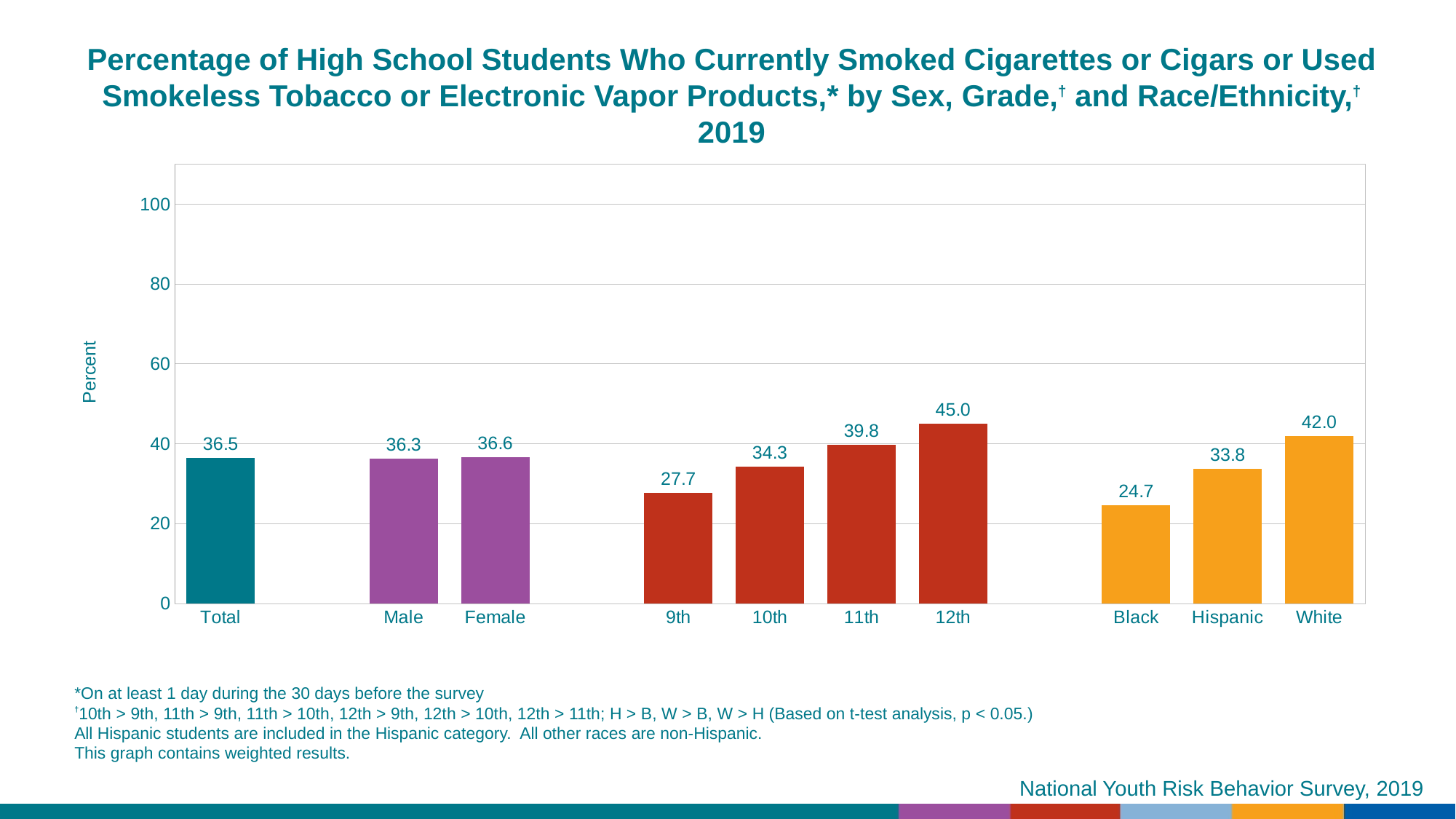
Which category has the highest value? 12th What is the difference between the values for 12th and 9th grade students? 17.3 What is the value for Black students? 24.7 Which is larger, the value for 11th grade or the value for Hispanic students? 11th Do the values rise or fall from 9th grade to 12th grade? rise What is the value for the Total category? 36.5 What kind of chart is shown on the slide? bar chart What is the value for 12th grade students? 45.0 How many categories are shown on the x axis? 10 Is the value for 9th grade greater or less than 40? less Which category has the lowest value? Black What is the difference between the values for White and Hispanic students? 8.2